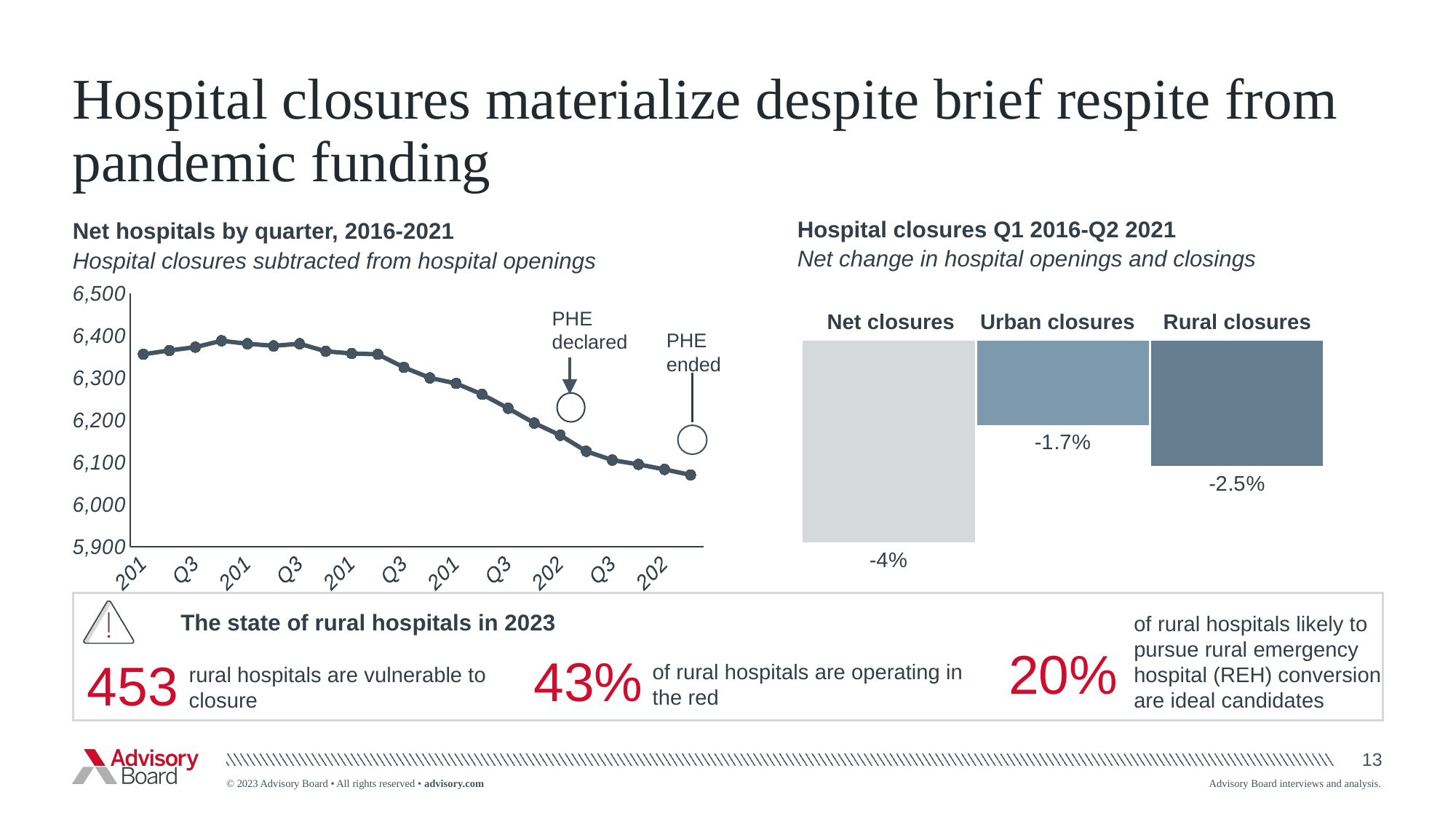
What kind of chart is the 'Hospital closures Q1 2016-Q2 2021' chart? Bar chart On the 'Hospital closures Q1 2016-Q2 2021' chart, what is the value for Urban closures? -1.7% On the 'Net hospitals by quarter, 2016-2021' chart, is the value for the last quarter shown greater or less than 6,100? less On the 'Net hospitals by quarter, 2016-2021' chart, do the values generally rise or fall from 2016 to 2021? Fall On the 'Hospital closures Q1 2016-Q2 2021' chart, which category shows the largest decline? Net closures What kind of chart is the 'Net hospitals by quarter, 2016-2021' chart? Line chart On the 'Hospital closures Q1 2016-Q2 2021' chart, what is the value for Net closures? -4% How many categories are shown on the 'Hospital closures Q1 2016-Q2 2021' chart? 3 On the 'Hospital closures Q1 2016-Q2 2021' chart, which shows a larger decline, Urban closures or Rural closures? Rural closures On the 'Hospital closures Q1 2016-Q2 2021' chart, what is the difference in percentage points between Rural closures and Urban closures? 0.8 percentage points On the 'Hospital closures Q1 2016-Q2 2021' chart, which category shows the smallest decline? Urban closures On the 'Hospital closures Q1 2016-Q2 2021' chart, what is the value for Rural closures? -2.5%